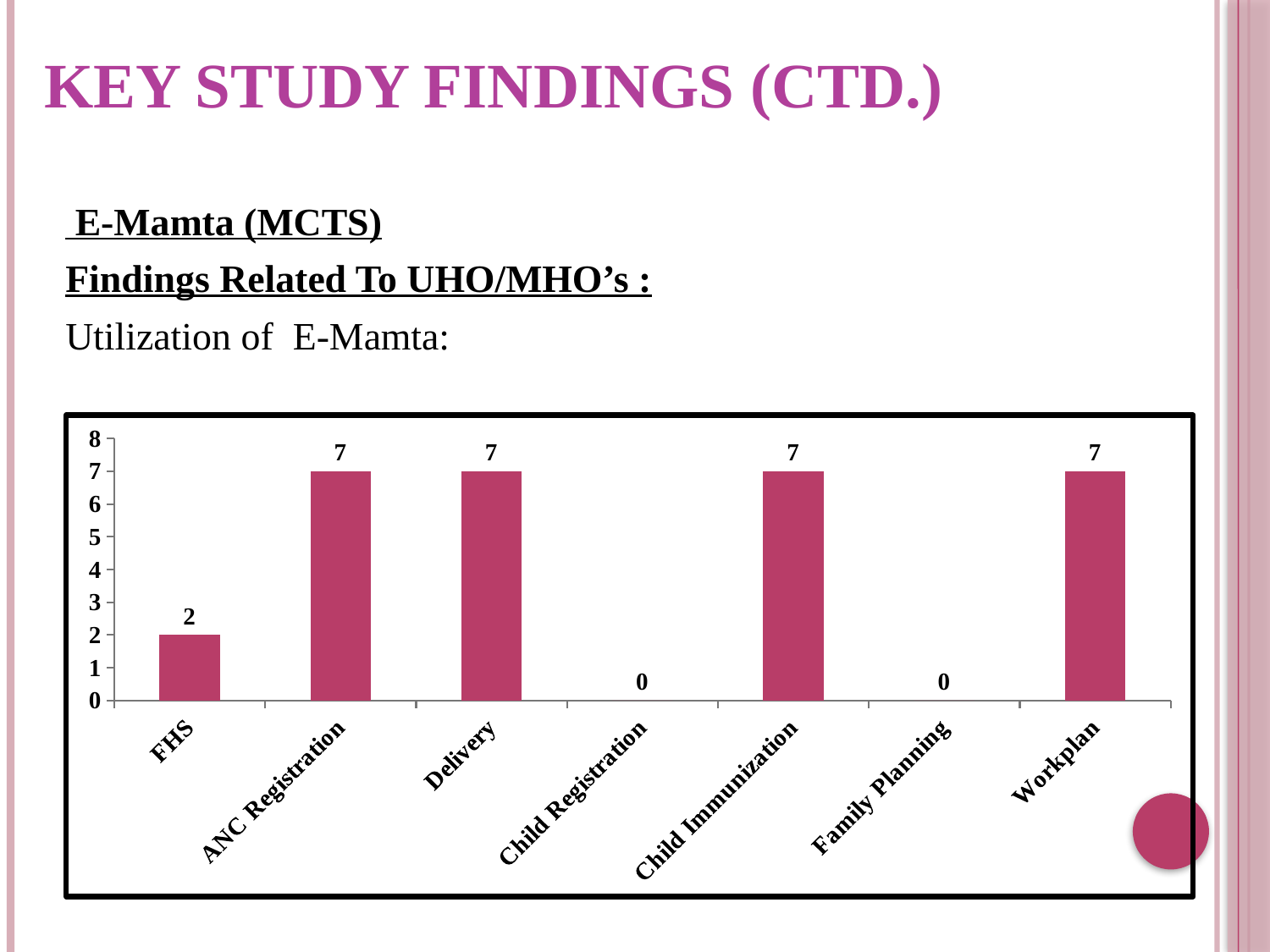
What is the value for Child Registration? 0 What is the value for Family Planning? 0 What is the highest value shown on the y axis of the chart? 8 What is the value for ANC Registration? 7 What is the value for FHS? 2 How many categories are shown on the x axis of the chart? 7 What is the difference between the values for Delivery and FHS? 5 What is the value for Workplan? 7 Which is larger, the value for FHS or the value for Child Immunization? Child Immunization Is the value for ANC Registration greater or less than 5? greater What kind of chart is shown on the slide? bar chart How many categories have a value of 0? 2